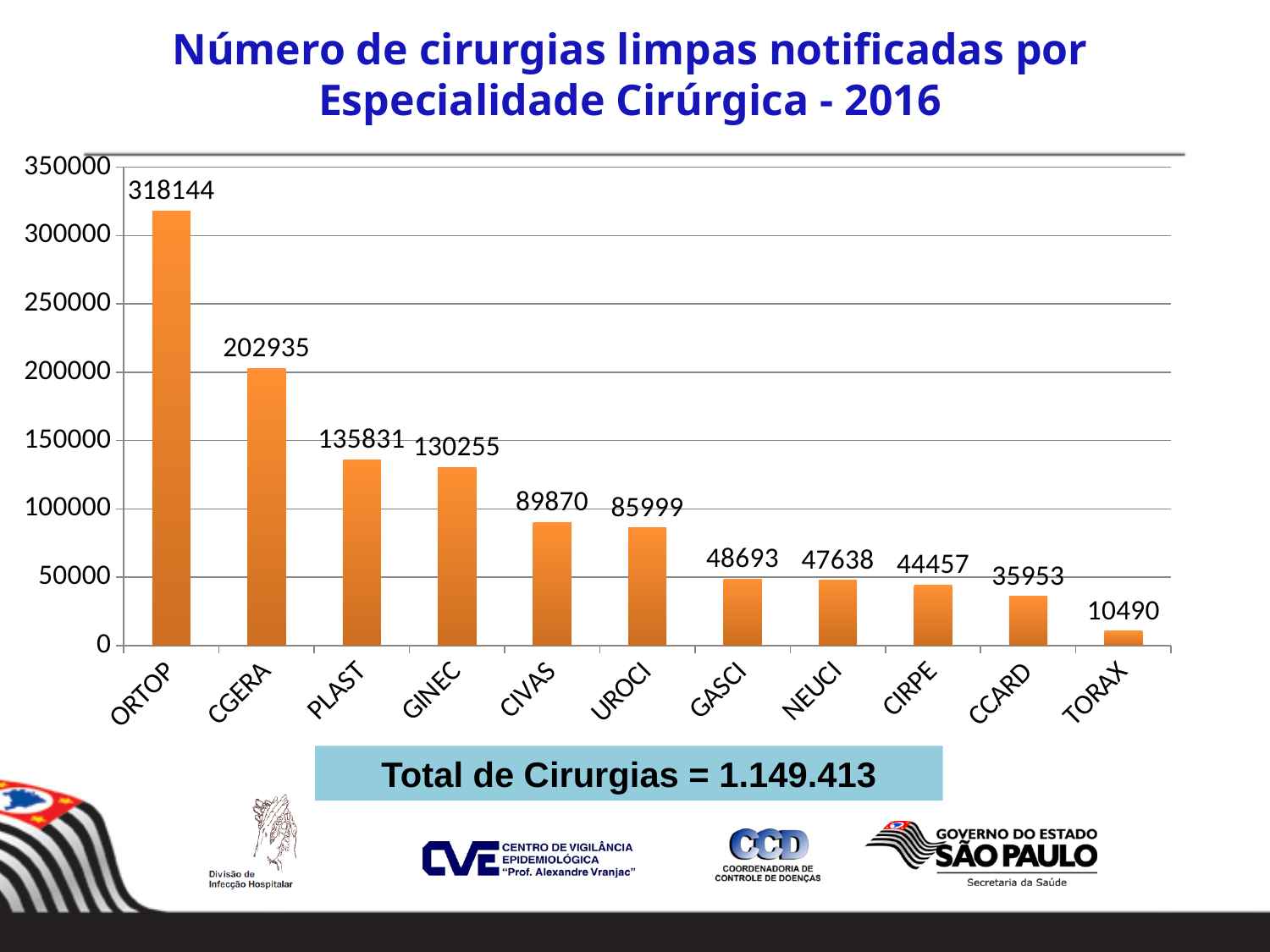
Which specialty has the highest number of clean surgeries? ORTOP What is the value for ORTOP? 318144 What is the value for TORAX? 10490 Which is larger, the value for CIVAS or the value for UROCI? CIVAS What is the difference between the values for ORTOP and CGERA? 115209 What is the value for GINEC? 130255 What kind of chart is shown on the slide? bar chart What total number of surgeries is stated below the chart? 1.149.413 Do the values rise or fall from left to right along the x axis? fall Is the value for PLAST greater or less than 150000? less How many surgical specialties are shown on the x axis? 11 Which specialty has the lowest number of clean surgeries? TORAX